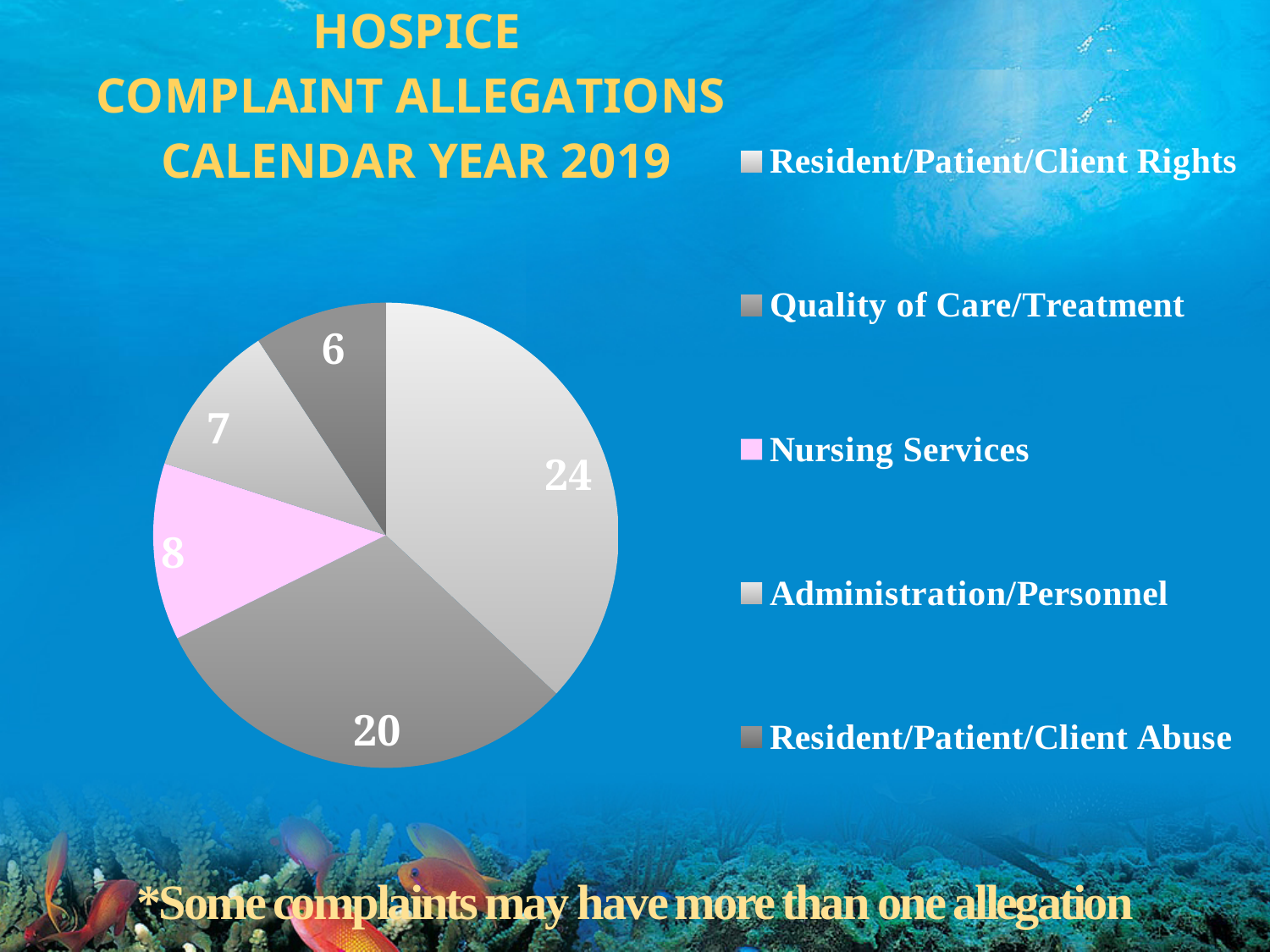
How many categories does the legend list? 5 Which is larger, the slice labelled 7 or the slice labelled 8? 8 What is the value of the Nursing Services slice (the pink slice)? 8 What is the title of the chart on the slide? Hospice Complaint Allegations Calendar Year 2019 What is the value of the smallest slice in the pie chart? 6 What is the value of the largest slice in the pie chart? 24 Which category has the smallest slice in the pie chart? Resident/Patient/Client Abuse What is the difference between the largest slice (24) and the second-largest slice (20)? 4 What kind of chart is shown on the slide? Pie chart What is the total of all the slice values in the pie chart? 65 Which category has the largest slice in the pie chart? Resident/Patient/Client Rights How many slices does the pie chart have? 5